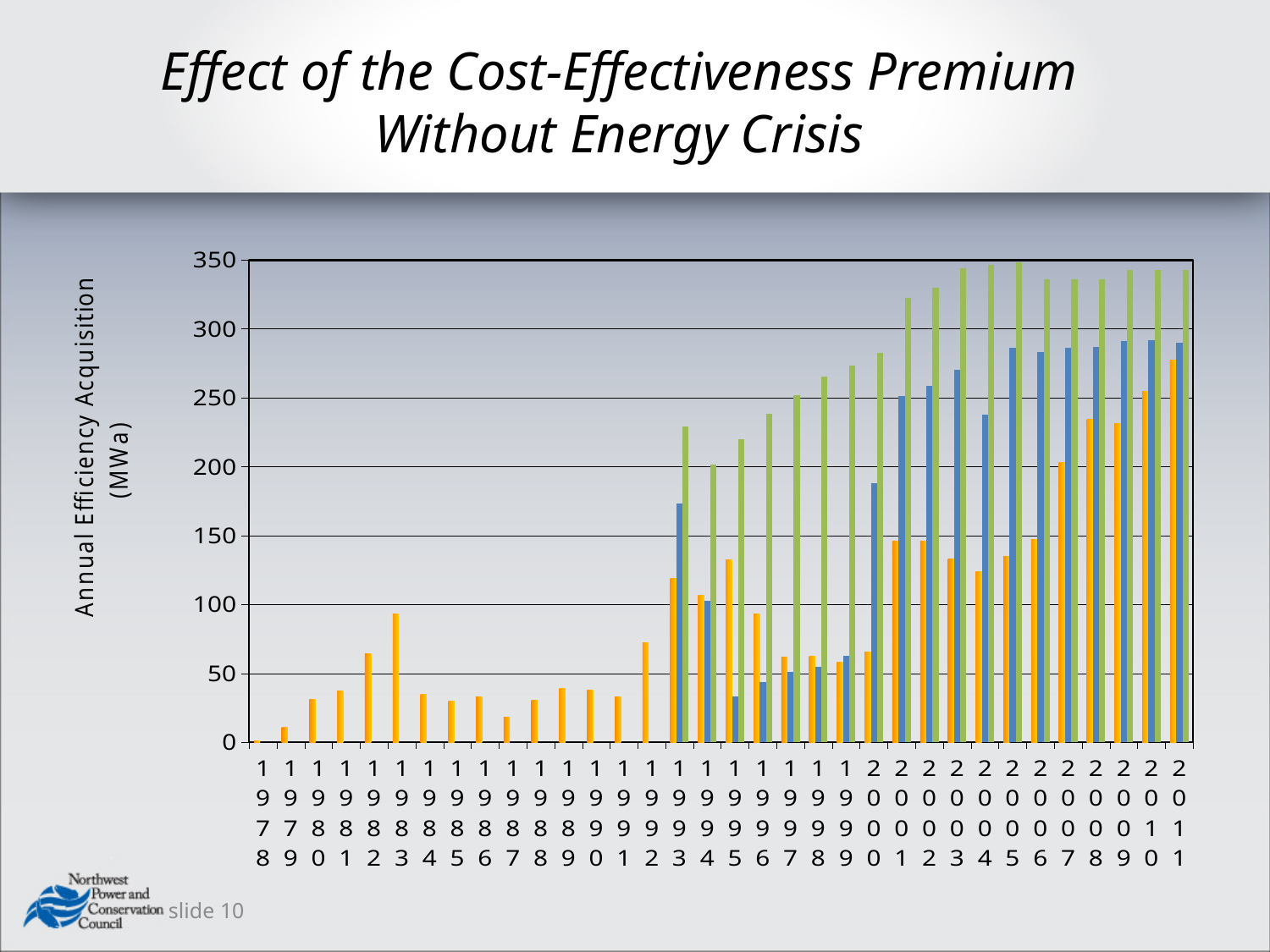
What kind of chart is shown on the slide? bar chart Is the value of the green bar for 2005 greater or less than 300? greater Do the green bars generally rise or fall from 1993 to 2005? rise Is the value of the orange bar for 1982 greater or less than 50? greater What is the title of the chart on the slide? Effect of the Cost-Effectiveness Premium Without Energy Crisis Is the value of the blue bar for 1996 greater or less than 50? less Which year has the highest orange bar? 2011 Which is larger for 1993, the green bar or the blue bar? green bar What is the label on the vertical axis of the chart? Annual Efficiency Acquisition (MWa) How many years are shown along the x axis of the chart? 34